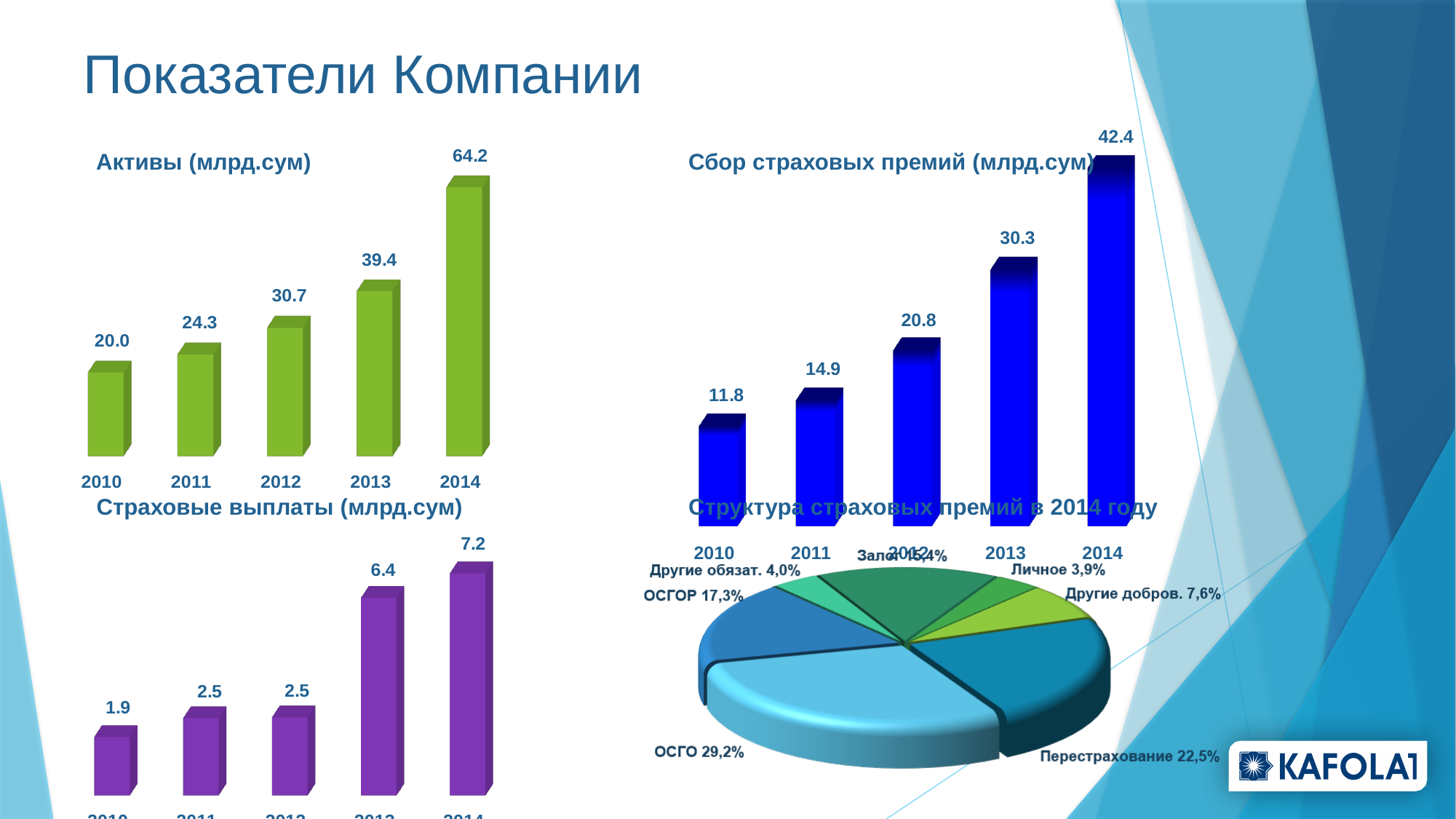
In the chart titled "Активы (млрд.сум)", what is the difference between the 2014 and 2013 values? 24.8 In the chart titled "Активы (млрд.сум)", how many years are shown on the x axis? 5 In the chart titled "Активы (млрд.сум)", what is the value for 2014? 64.2 In the pie chart titled "Структура страховых премий в 2014 году", which is larger: Перестрахование or ОСГОР? Перестрахование In the chart titled "Сбор страховых премий (млрд.сум)", do the values rise or fall from 2010 to 2014? rise In the pie chart titled "Структура страховых премий в 2014 году", what share does Личное have? 3,9% In the chart titled "Сбор страховых премий (млрд.сум)", what kind of chart is it? bar chart In the chart titled "Страховые выплаты (млрд.сум)", what is the difference between the two tallest bars, 7.2 and 6.4? 0.8 In the chart titled "Страховые выплаты (млрд.сум)", what is the highest value shown? 7.2 In the chart titled "Сбор страховых премий (млрд.сум)", which year has the lowest value? 2010 In the pie chart titled "Структура страховых премий в 2014 году", what share does ОСГО have? 29,2% In the chart titled "Сбор страховых премий (млрд.сум)", what is the value for 2012? 20.8